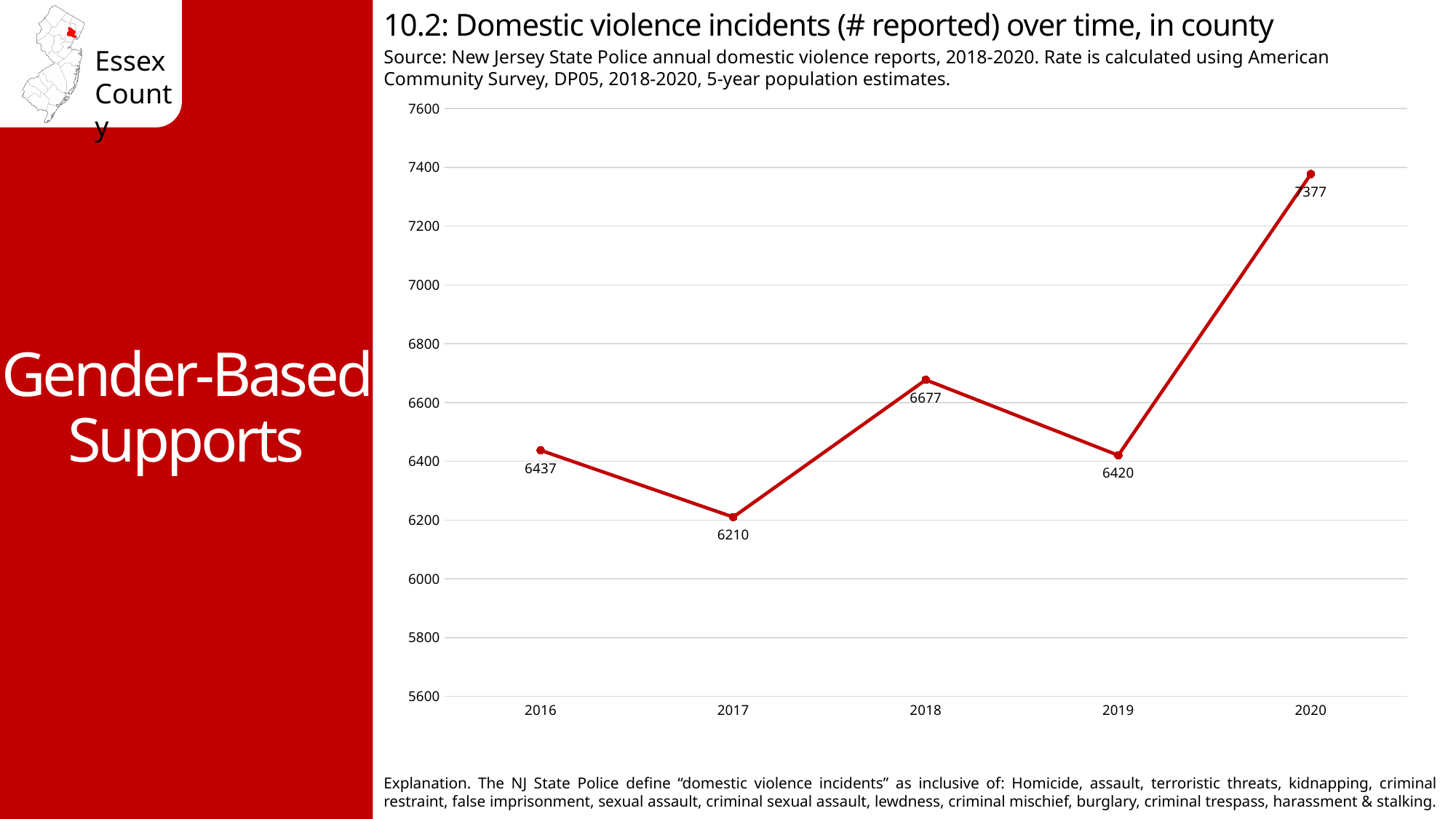
Is the value for 2018 greater or less than 6600? greater Did the number of reported incidents rise or fall from 2019 to 2020? rise What kind of chart is shown on the slide? line chart What is the value plotted for 2020? 7377 Which year has the lowest number of reported domestic violence incidents? 2017 Which year has the highest number of reported domestic violence incidents? 2020 Which year has a larger value, 2016 or 2019? 2016 How many domestic violence incidents were reported in 2018? 6677 What is the difference between the 2020 value and the 2019 value? 957 What is the difference between the 2016 value and the 2017 value? 227 What is the value plotted for 2017? 6210 How many years are plotted on the chart? 5